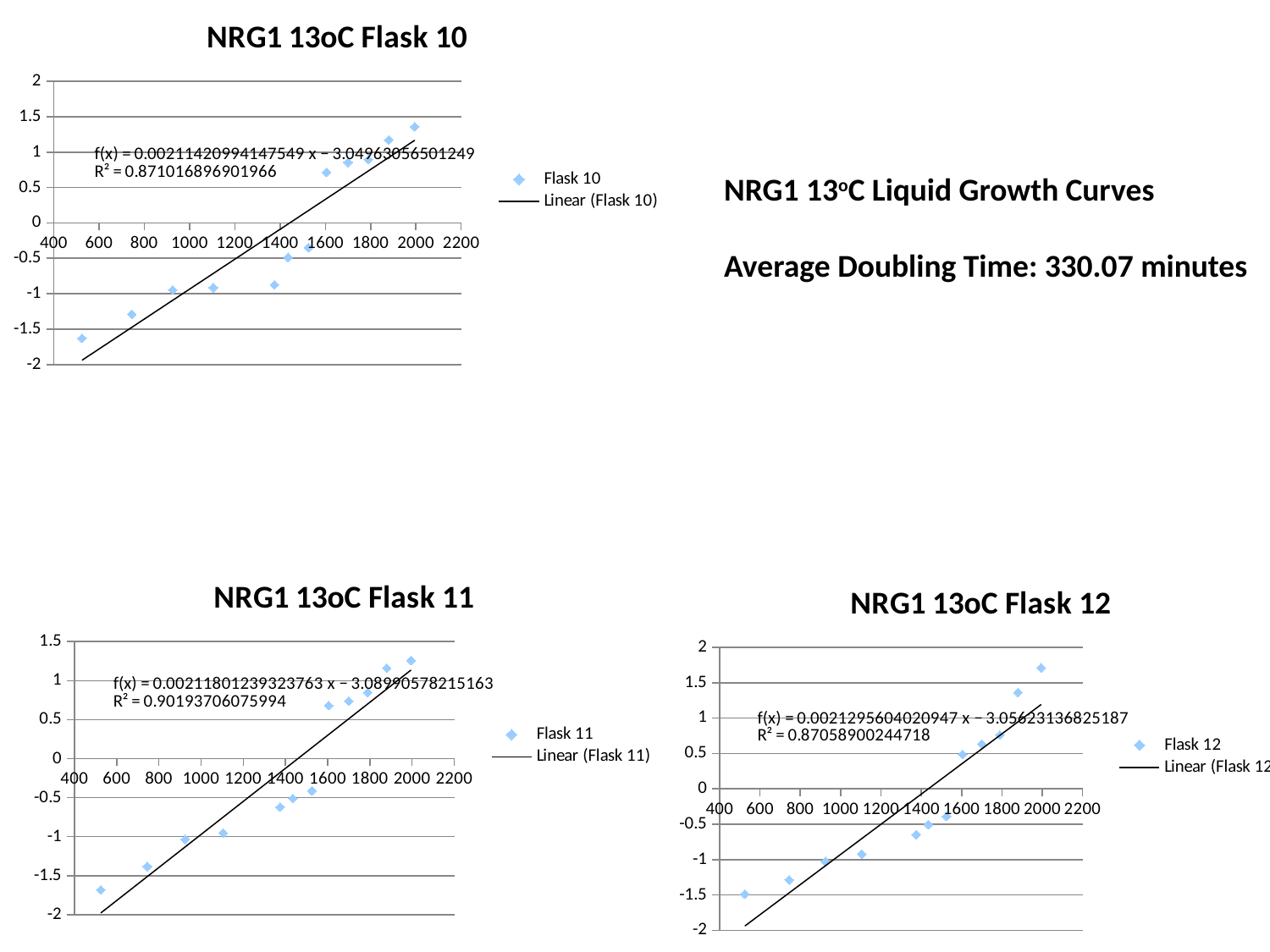
What are the two legend entries in the NRG1 13oC Flask 12 chart? Flask 12 and Linear (Flask 12) In the NRG1 13oC Flask 10 chart, what is the R² value shown? 0.871016896901966 What kind of chart is the NRG1 13oC Flask 10 chart? scatter chart Which of the three charts shows the lowest R² value? NRG1 13oC Flask 12 In the NRG1 13oC Flask 11 chart, is the value of the leftmost point (near x = 500) greater or less than -1? less In the NRG1 13oC Flask 12 chart, is the value of the point at x = 2000 greater or less than 1.5? greater In the NRG1 13oC Flask 12 chart, what is the R² value shown? 0.87058900244718 How many entries does the legend of the NRG1 13oC Flask 11 chart list? 2 Is the R² value in the NRG1 13oC Flask 11 chart larger or smaller than the R² value in the NRG1 13oC Flask 10 chart? larger Which of the three charts shows the highest R² value? NRG1 13oC Flask 11 In the NRG1 13oC Flask 11 chart, what is the R² value shown? 0.90193706075994 In the NRG1 13oC Flask 10 chart, do the Flask 10 values rise or fall as x increases? rise